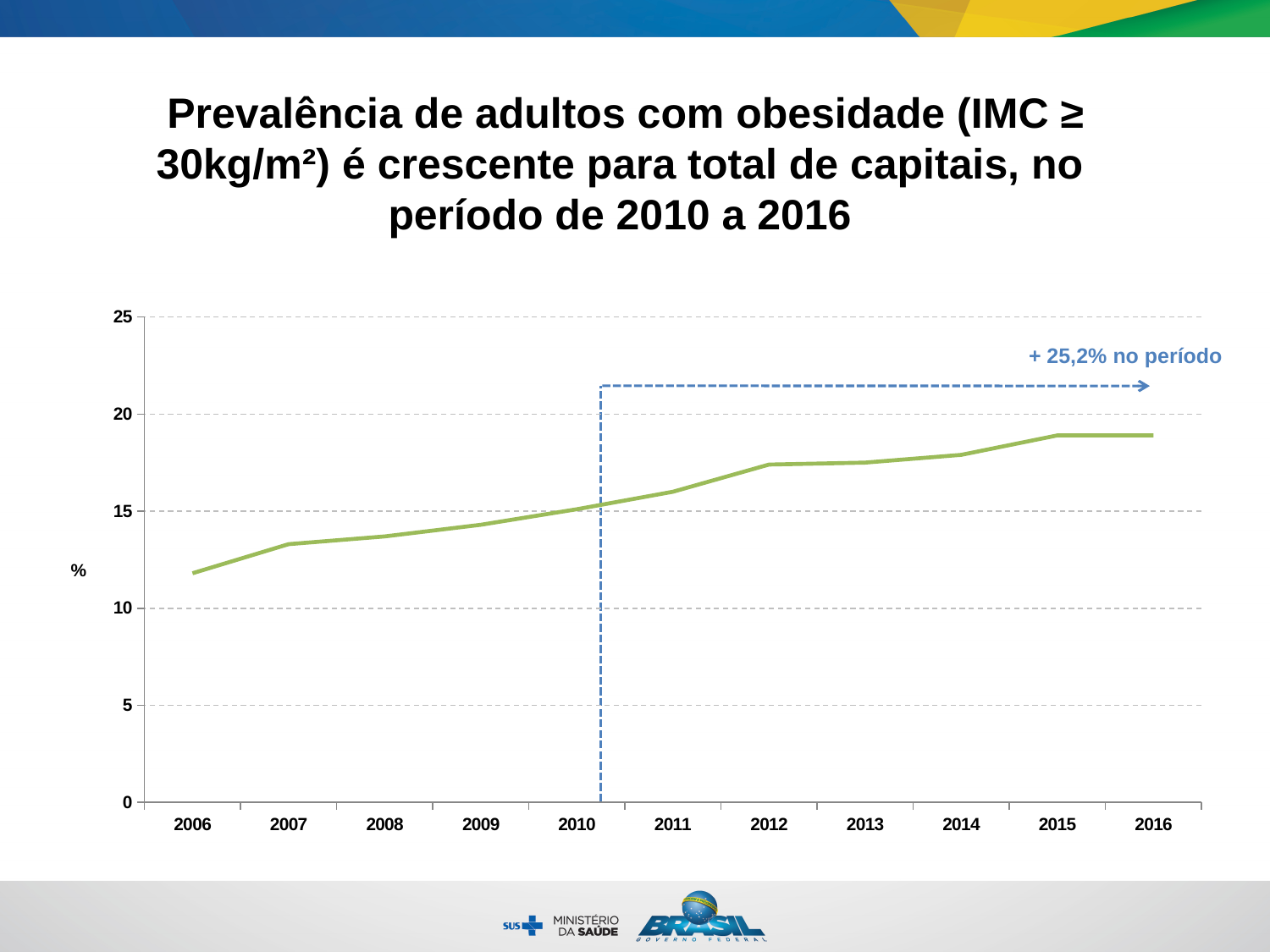
Is the value for 2012 greater or less than 15? greater What percentage change is stated in the annotation above the line in the chart? + 25,2% no período Is the value for 2006 greater or less than 15? less Which is larger, the value for 2007 or the value for 2014? 2014 Which year has the lowest prevalence value in the chart? 2006 Is the value for 2016 greater or less than 20? less What kind of chart is shown on the slide? line chart How many years are plotted along the x axis of the chart? 11 Do the values in the chart rise or fall from 2006 to 2016? rise What label is shown on the y axis of the chart? % Which is larger, the value for 2006 or the value for 2016? 2016